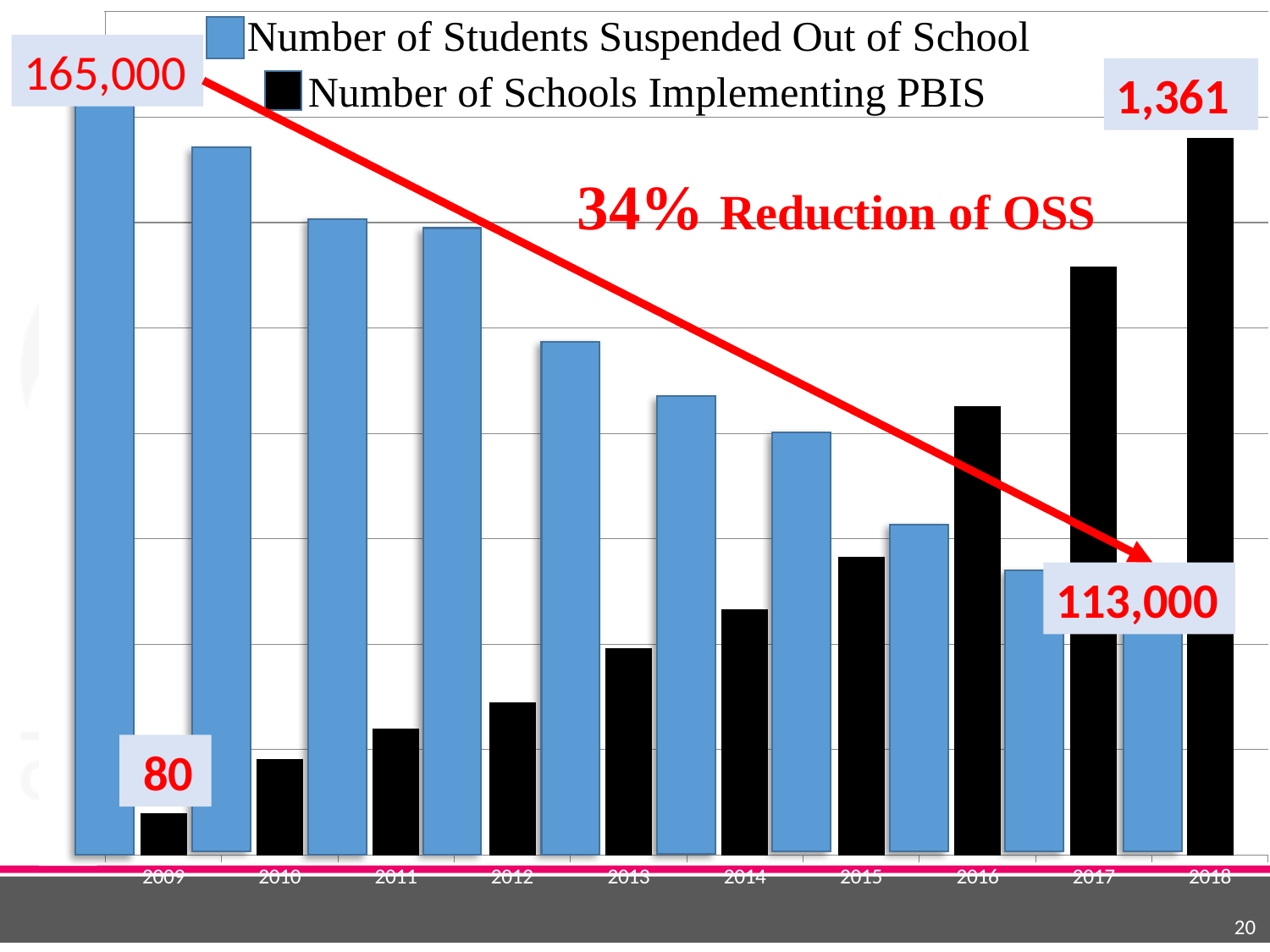
In which year is the Number of Students Suspended Out of School highest? 2009 What is the Number of Students Suspended Out of School in 2018? 113,000 What is the difference between the Number of Schools Implementing PBIS in 2018 and in 2009? 1,281 In which year is the Number of Schools Implementing PBIS lowest? 2009 What is the Number of Schools Implementing PBIS in 2018? 1,361 How many years are shown on the x axis? 10 What is the Number of Students Suspended Out of School in 2009? 165,000 What percentage reduction of OSS does the chart annotation state? 34% Does the Number of Students Suspended Out of School rise or fall from 2009 to 2018? fall How many series does the legend list? 2 By how much did the Number of Students Suspended Out of School fall from 2009 to 2018? 52,000 What is the Number of Schools Implementing PBIS in 2009? 80